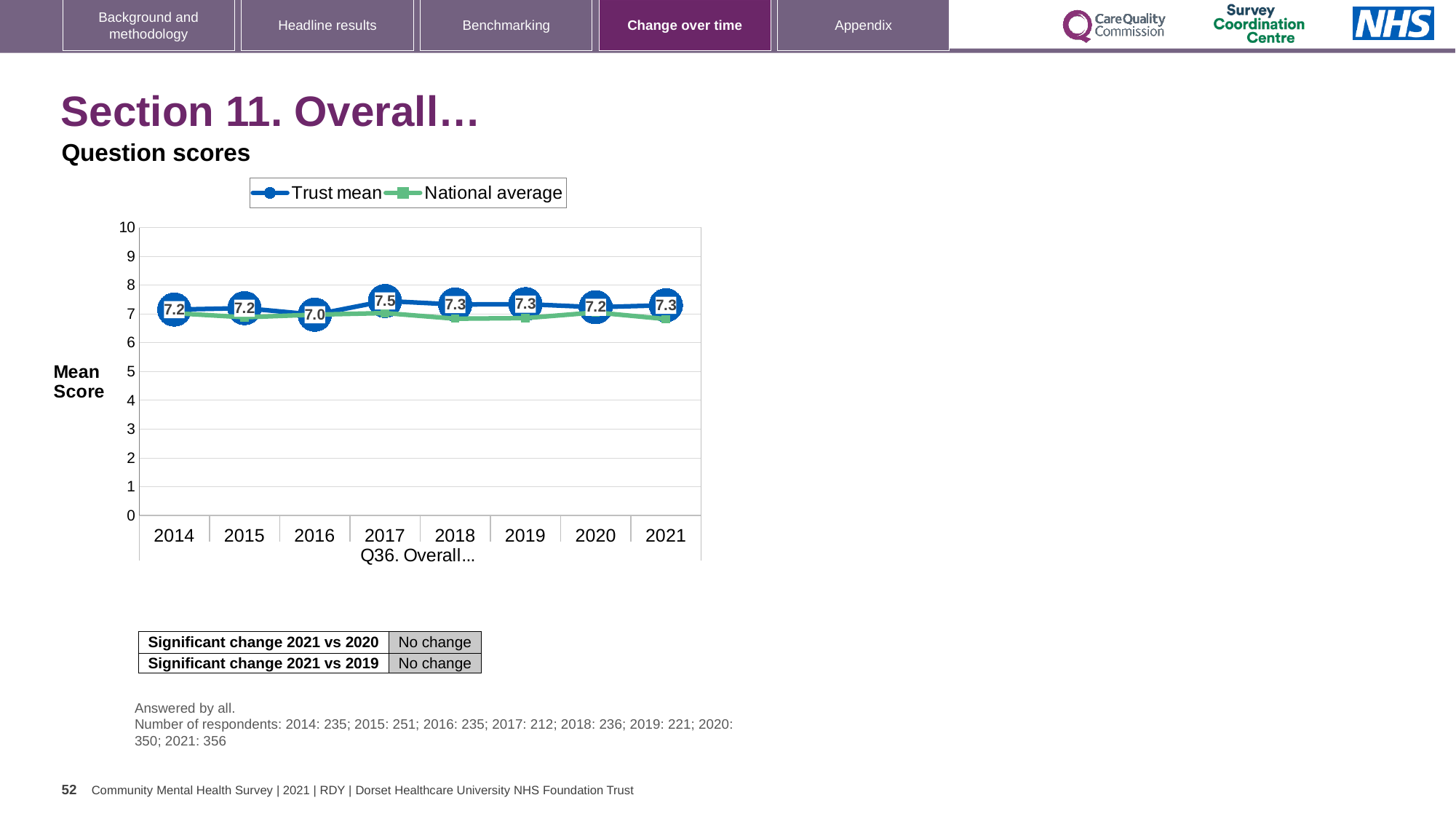
Is the National average value for 2021 greater or less than 8? less What is the difference between the Trust mean in 2017 and in 2016? 0.5 What is the Trust mean for 2021? 7.3 How many years are shown on the x axis? 8 What is the label on the y axis of the chart? Mean Score What is the Trust mean for 2016? 7.0 In which year is the Trust mean lowest? 2016 In which year is the Trust mean highest? 2017 How many series does the legend list? 2 Which year has the larger Trust mean, 2017 or 2020? 2017 What kind of chart is shown on the slide? line chart What is the Trust mean for 2017? 7.5